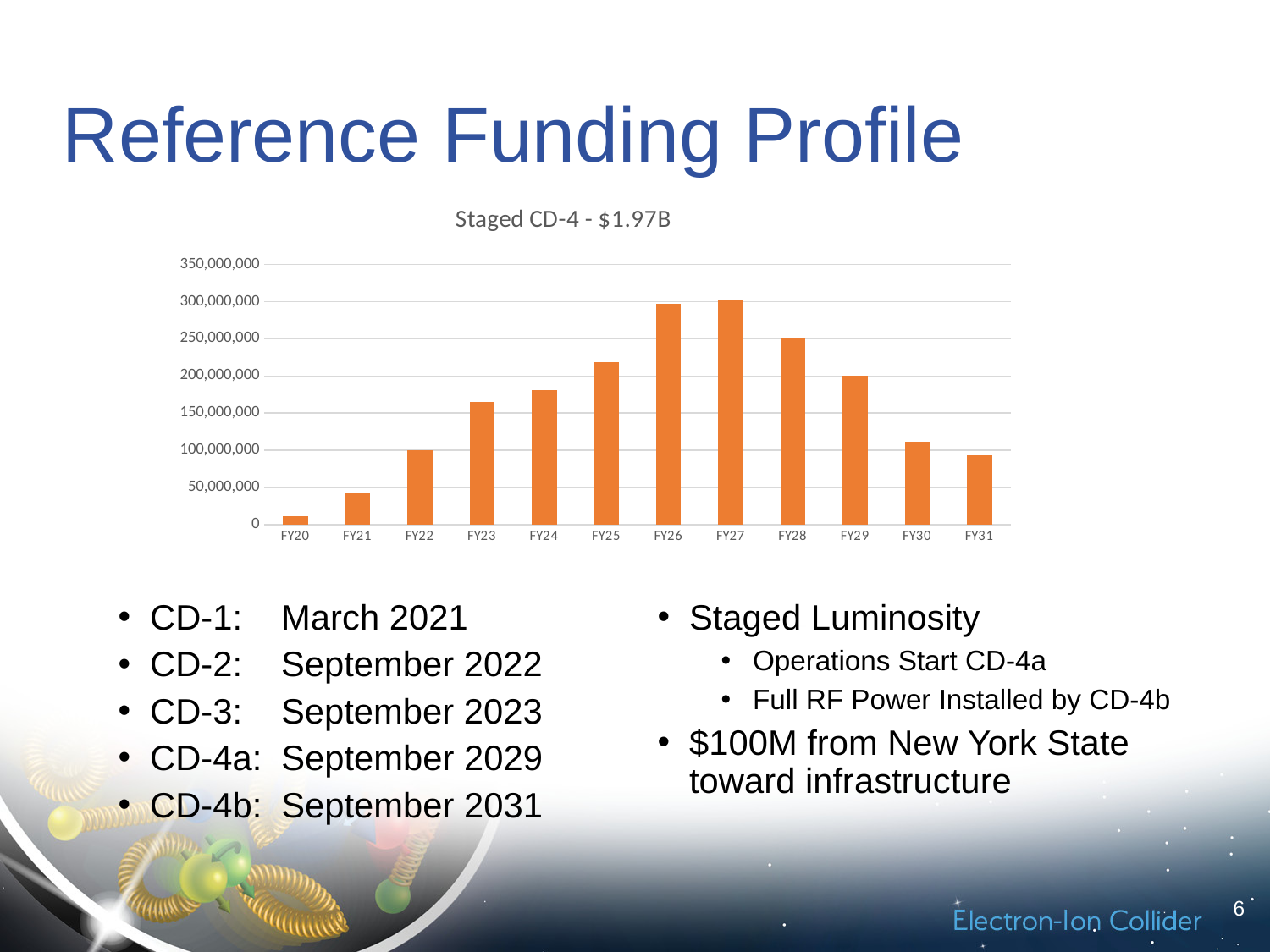
What kind of chart is shown on the slide? bar chart Is the value for FY26 greater or less than 250,000,000? greater Do the values rise or fall from FY20 to FY27? rise Is the value for FY25 greater or less than 200,000,000? greater What colour are the bars in the chart? orange Which has the larger value, FY28 or FY29? FY28 What is the title of the chart? Staged CD-4 - $1.97B Which has the larger value, FY23 or FY24? FY24 Which fiscal year has the lowest funding value in the chart? FY20 How many fiscal years are shown on the x axis of the chart? 12 Is the value for FY31 greater or less than 100,000,000? less